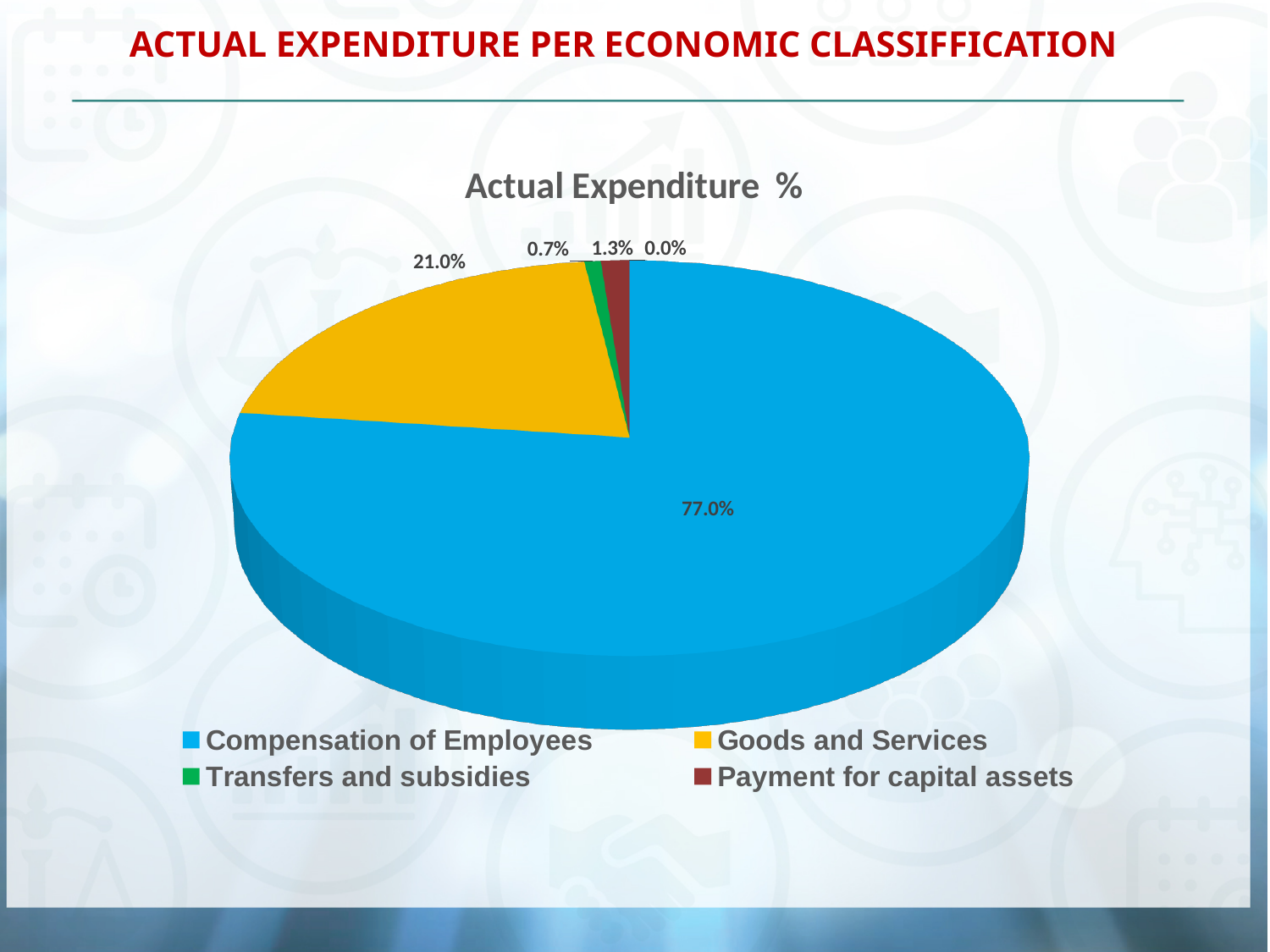
What percentage of actual expenditure is Payment for capital assets? 1.3% What colour is the slice for Goods and Services? yellow What is the title of the chart? Actual Expenditure % How many categories does the legend list? 4 What percentage of actual expenditure is Goods and Services? 21.0% What percentage of actual expenditure is Transfers and subsidies? 0.7% What type of chart is shown on the slide? pie chart Which is larger, Payment for capital assets or Transfers and subsidies? Payment for capital assets Which category has the largest share of actual expenditure? Compensation of Employees Which legend category has the smallest share of actual expenditure? Transfers and subsidies What is the difference in percentage points between Compensation of Employees and Goods and Services? 56.0 What percentage of actual expenditure is Compensation of Employees? 77.0%